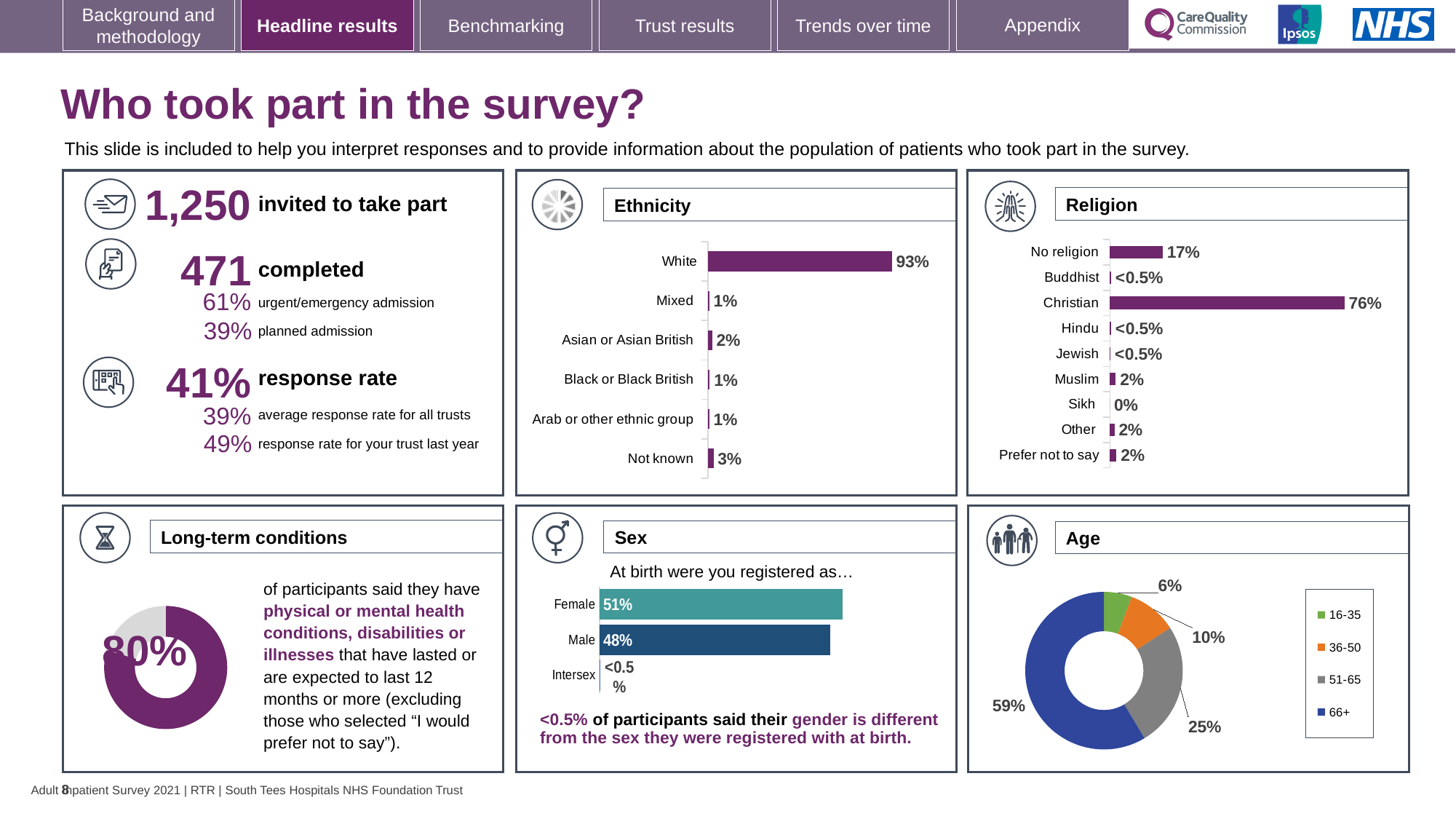
In the Ethnicity chart, how many ethnicity categories are shown? 6 In the Sex chart, what percentage of participants were registered as Male at birth? 48% In the Sex chart, which is larger, the Female value or the Male value? Female In the Ethnicity chart, which category has the highest value? White In the Ethnicity chart, what percentage of participants were White? 93% In the Religion chart, what percentage of participants were Christian? 76% In the Religion chart, how many religion categories are listed? 9 In the Religion chart, which category has the lowest value? Sikh In the Age chart, what share of participants were aged 66+? 59% In the Age chart, how many age groups does the legend list? 4 In the Religion chart, what is the difference between the Christian and No religion values? 59 percentage points What kind of chart is used for the Age breakdown? Donut chart